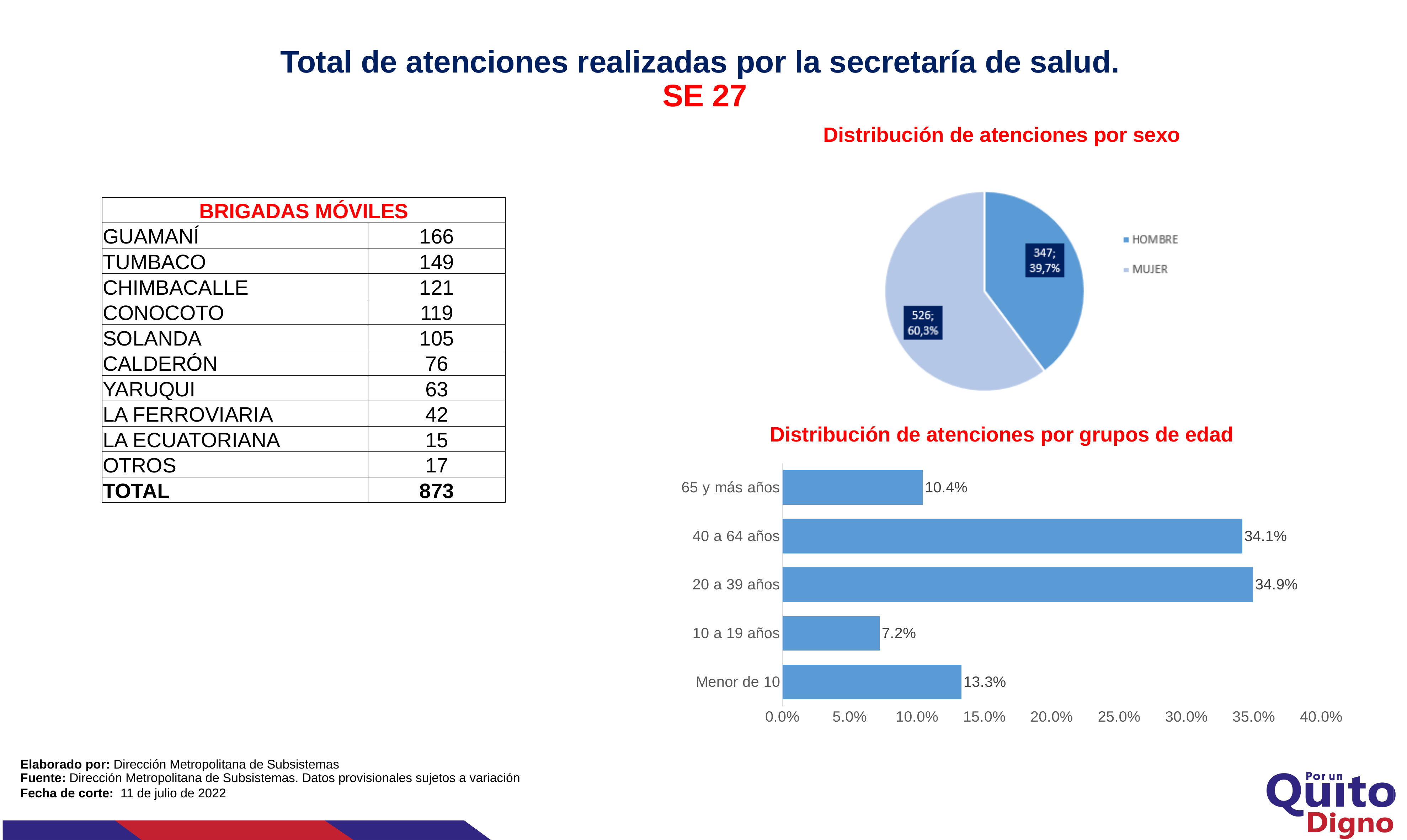
In the 'Distribución de atenciones por sexo' pie chart, what is the difference in count between MUJER and HOMBRE? 179 What kind of chart is 'Distribución de atenciones por grupos de edad'? Bar chart How many entries does the legend of the 'Distribución de atenciones por sexo' chart list? 2 In the 'Distribución de atenciones por grupos de edad' chart, which age group has the lowest value? 10 a 19 años In the 'Distribución de atenciones por sexo' pie chart, which category has the larger slice, HOMBRE or MUJER? MUJER In the 'Distribución de atenciones por sexo' pie chart, what share of the pie does MUJER represent? 60,3% In the 'Distribución de atenciones por grupos de edad' chart, what is the difference between '20 a 39 años' and '65 y más años'? 24.5% In the 'Distribución de atenciones por grupos de edad' chart, what is the value for 'Menor de 10'? 13.3% How many age groups are shown in the 'Distribución de atenciones por grupos de edad' chart? 5 In the 'Distribución de atenciones por grupos de edad' chart, what is the value for '40 a 64 años'? 34.1% In the 'Distribución de atenciones por sexo' pie chart, what value is shown for HOMBRE? 347; 39,7% In the 'Distribución de atenciones por grupos de edad' chart, which age group has the highest value? 20 a 39 años